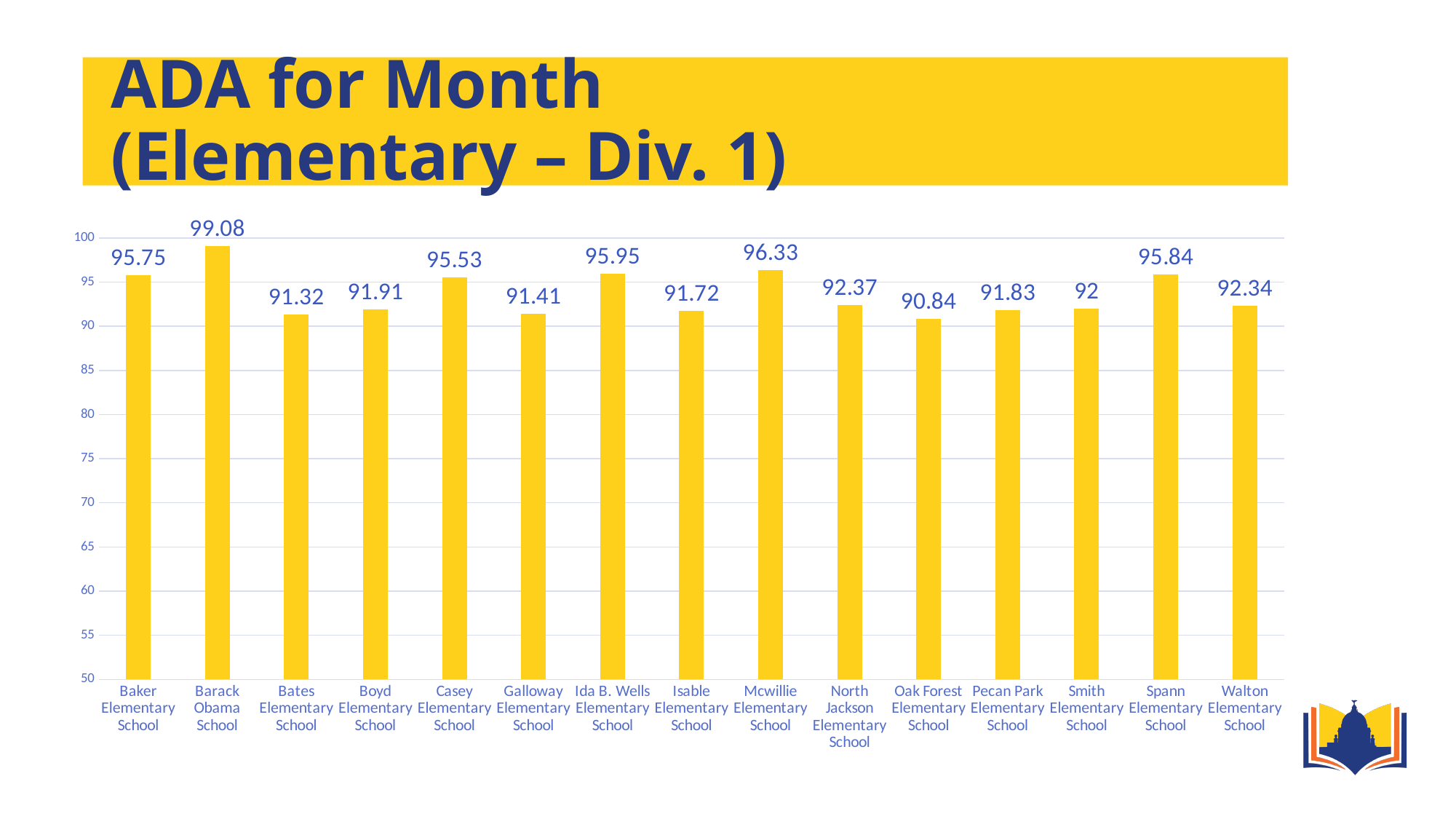
Which school has the highest ADA for the month? Barack Obama School What type of chart is shown on the slide? bar chart What is the ADA value for Oak Forest Elementary School? 90.84 Which school has the lowest ADA for the month? Oak Forest Elementary School What is the ADA value for Smith Elementary School? 92 How many schools are shown in the chart? 15 What is the ADA value for Mcwillie Elementary School? 96.33 What is the difference between the ADA values of Barack Obama School and Oak Forest Elementary School? 8.24 What is the title of the slide? ADA for Month (Elementary – Div. 1) What is the ADA value for Barack Obama School? 99.08 Is the ADA value for Bates Elementary School greater or less than 95? less Which has a higher ADA value, Spann Elementary School or Walton Elementary School? Spann Elementary School